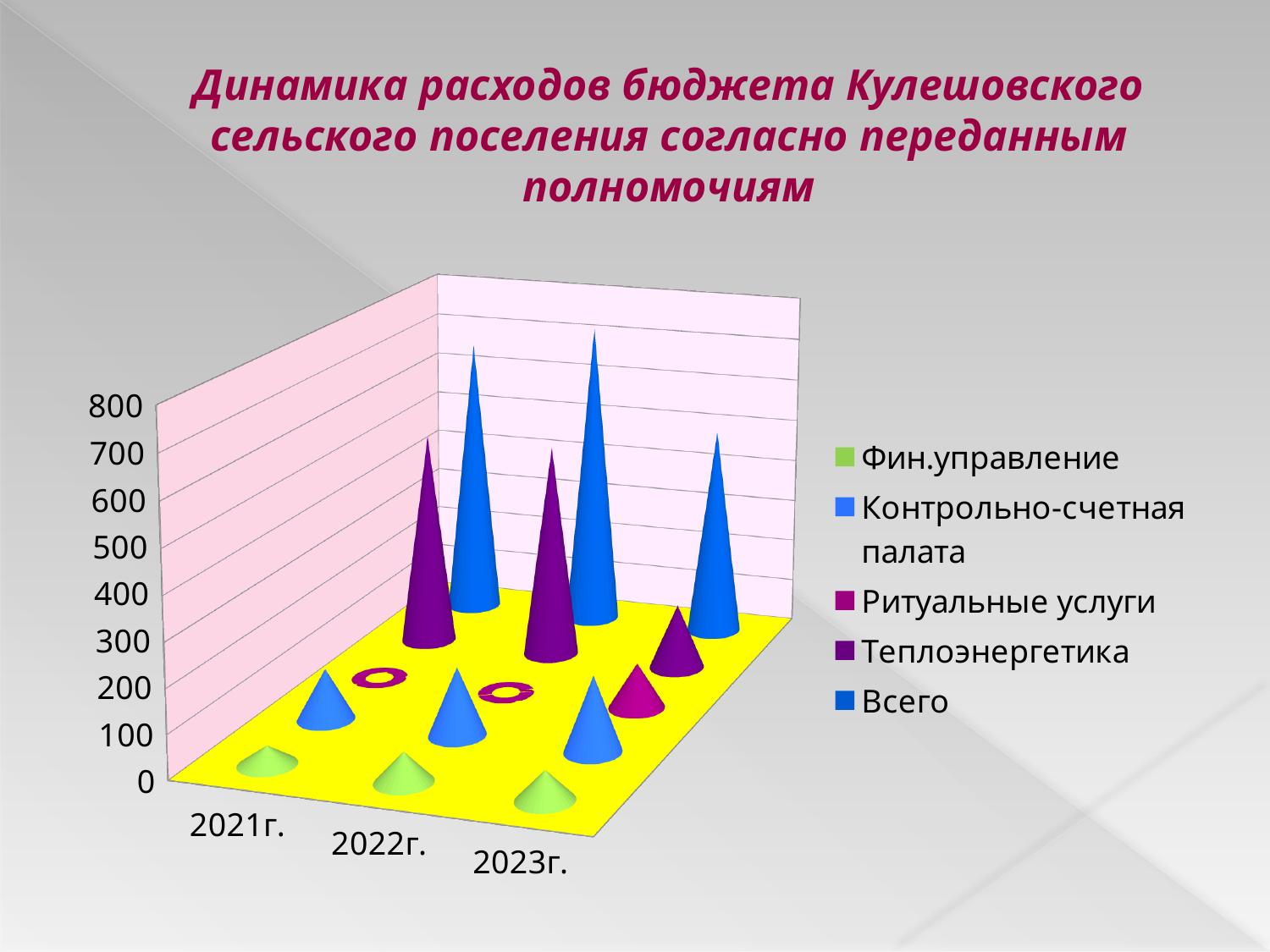
What kind of chart is shown on the slide? bar chart Which series has the highest value in 2021г.? Всего Which is larger, Теплоэнергетика in 2021г. or Теплоэнергетика in 2023г.? 2021г. Which series is listed last in the legend? Всего How many series does the legend list? 5 Does the value for Теплоэнергетика rise or fall from 2021г. to 2023г.? fall Which series is listed first in the legend? Фин.управление Is the value for Фин.управление in 2021г. greater or less than 100? less In which year is the value for Всего the highest? 2022г. How many years are shown on the x axis of the chart? 3 In which year is the value for Всего the lowest? 2023г. Which series has the lowest value in 2021г.? Ритуальные услуги